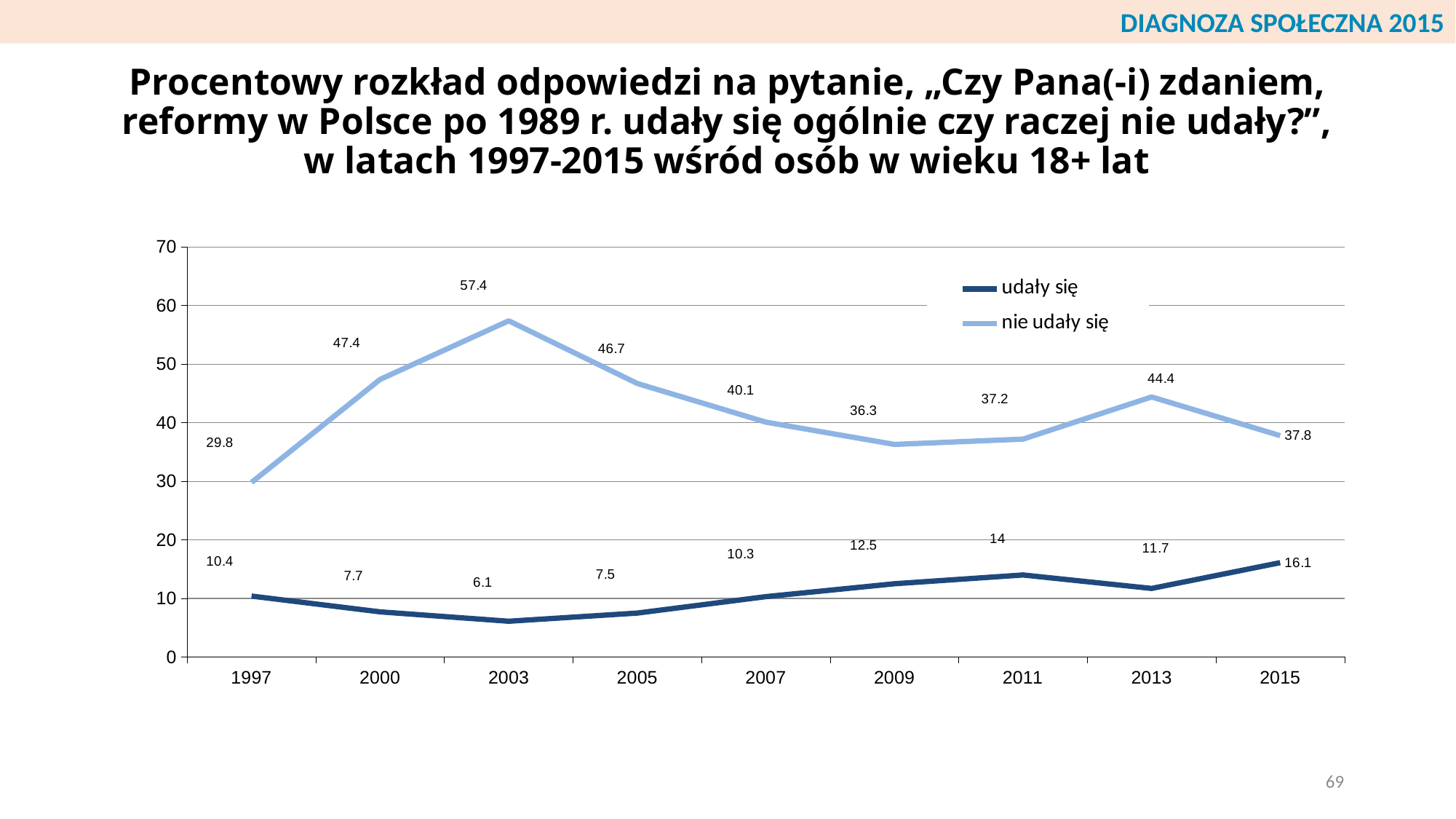
In which year is the "nie udały się" series highest? 2003 Does the "udały się" series rise or fall from 2003 to 2011? rise What kind of chart is shown on the slide? line chart What is the value for "nie udały się" in 2003? 57.4 Which is larger: "nie udały się" in 2013 or "nie udały się" in 2015? 2013 What is the difference between "nie udały się" and "udały się" in 2015? 21.7 What is the value for "udały się" in 2015? 16.1 How many years are shown on the x axis? 9 Is the value for "nie udały się" in 1997 greater or less than 40? less In which year is the "udały się" series lowest? 2003 What is the value for "udały się" in 2011? 14 How many series does the legend list? 2